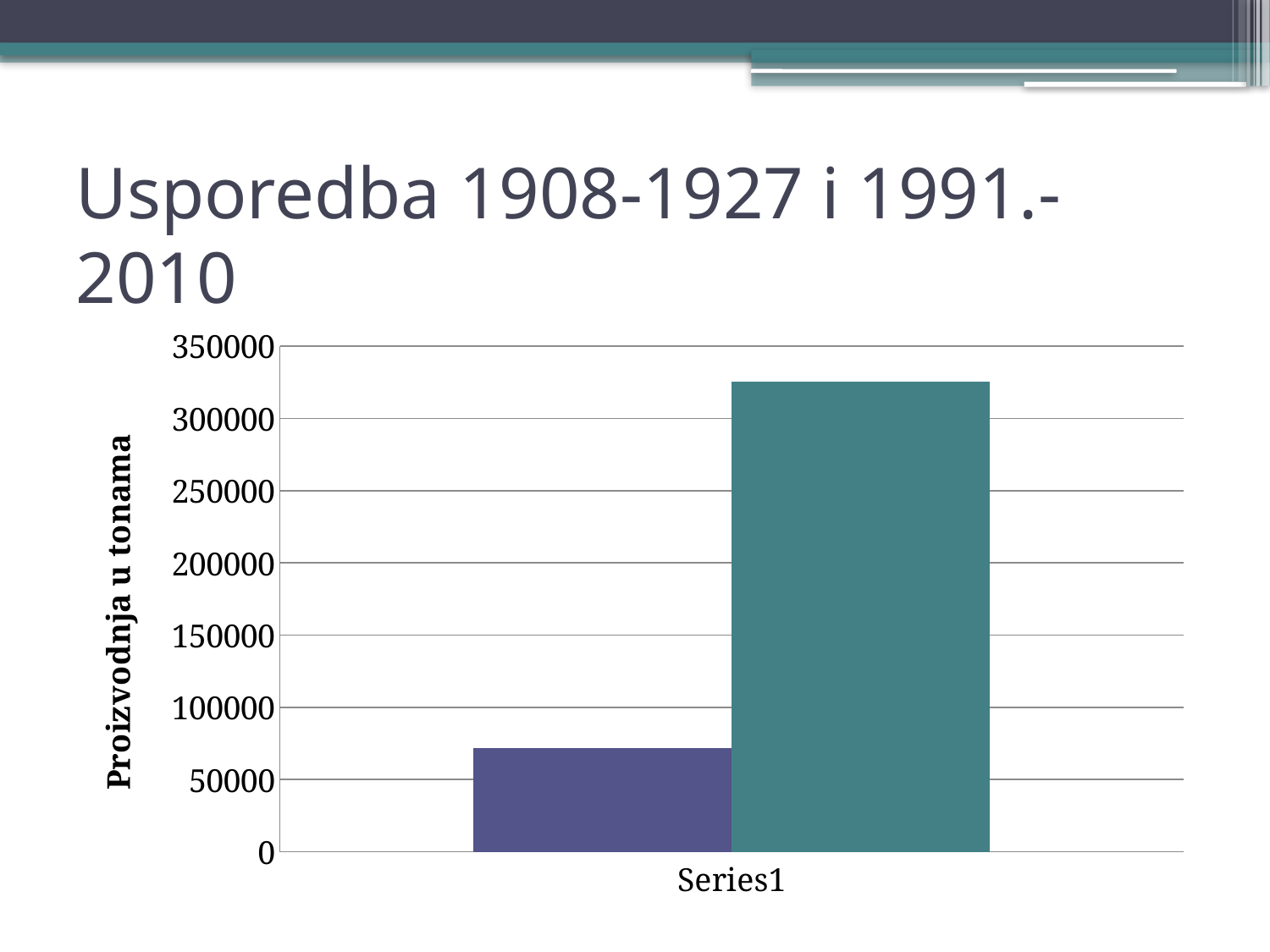
What label appears under the bars on the horizontal axis? Series1 Which bar has the lowest value, the purple one or the teal one? the purple one Which bar is taller, the purple bar on the left or the teal bar on the right? the teal bar on the right Is the value of the purple (left) bar greater or less than 50000? greater What kind of chart is shown on the slide? bar chart What is the title of the vertical axis? Proizvodnja u tonama Is the value of the teal (right) bar greater or less than 350000? less How many bars are plotted in the chart? 2 Is the value of the teal (right) bar greater or less than 300000? greater What is the highest value shown on the vertical axis? 350000